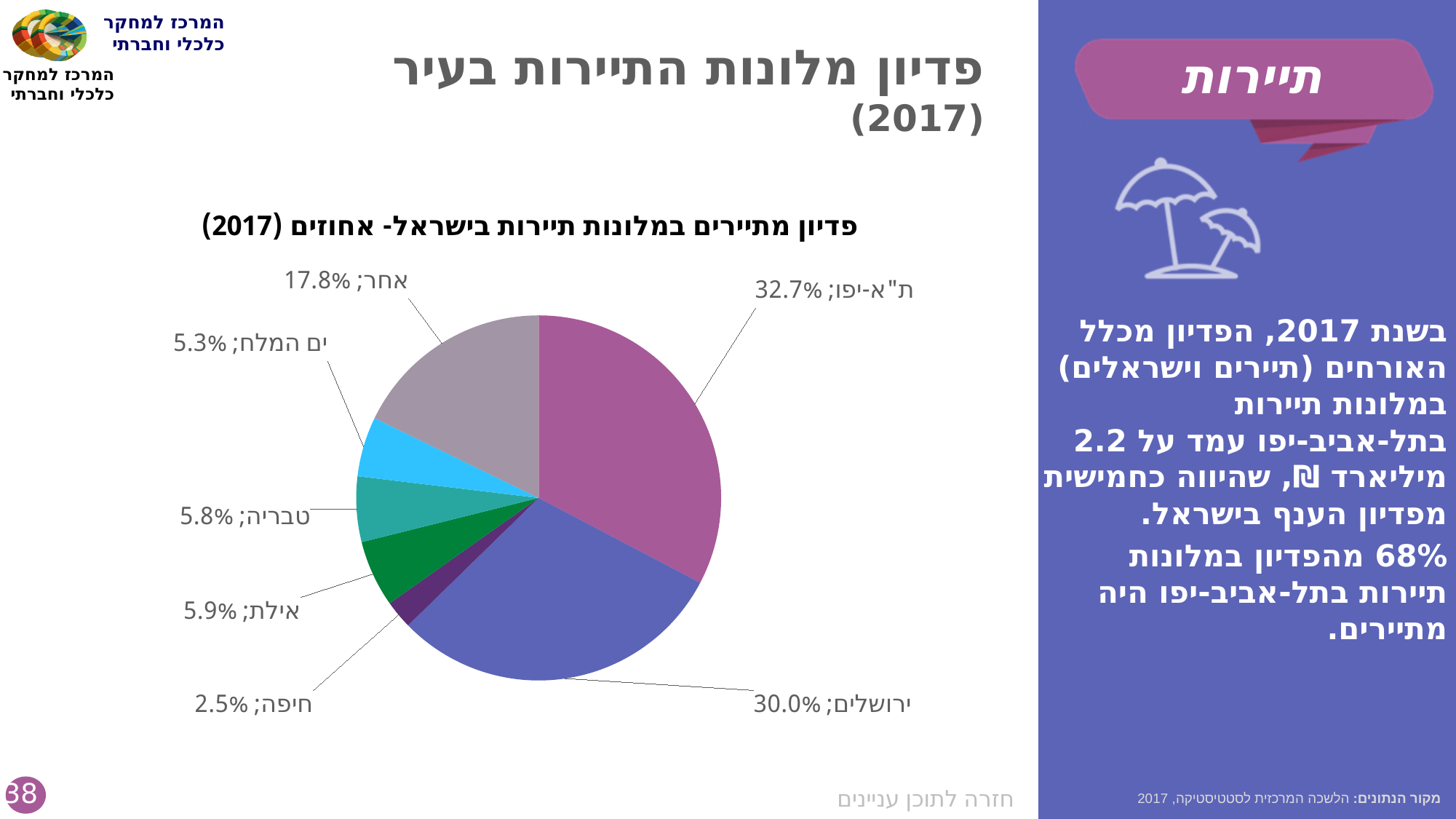
What is the value shown for חיפה (Haifa)? 2.5% What is the combined share of ת"א-יפו and ירושלים? 62.7% How many slices does the pie chart have? 7 Which category has the largest slice of the pie? ת"א-יפו What is the value shown for אחר (Other)? 17.8% Which category has the smallest slice of the pie? חיפה What is the difference between the shares of ת"א-יפו and ירושלים? 2.7% What share of the pie does ירושלים (Jerusalem) hold? 30.0% What year is given in the chart title? 2017 What type of chart is shown on the slide? Pie chart Which is larger, the share for אילת or the share for ים המלח? אילת What share of the pie does ת"א-יפו (Tel Aviv-Yafo) hold? 32.7%